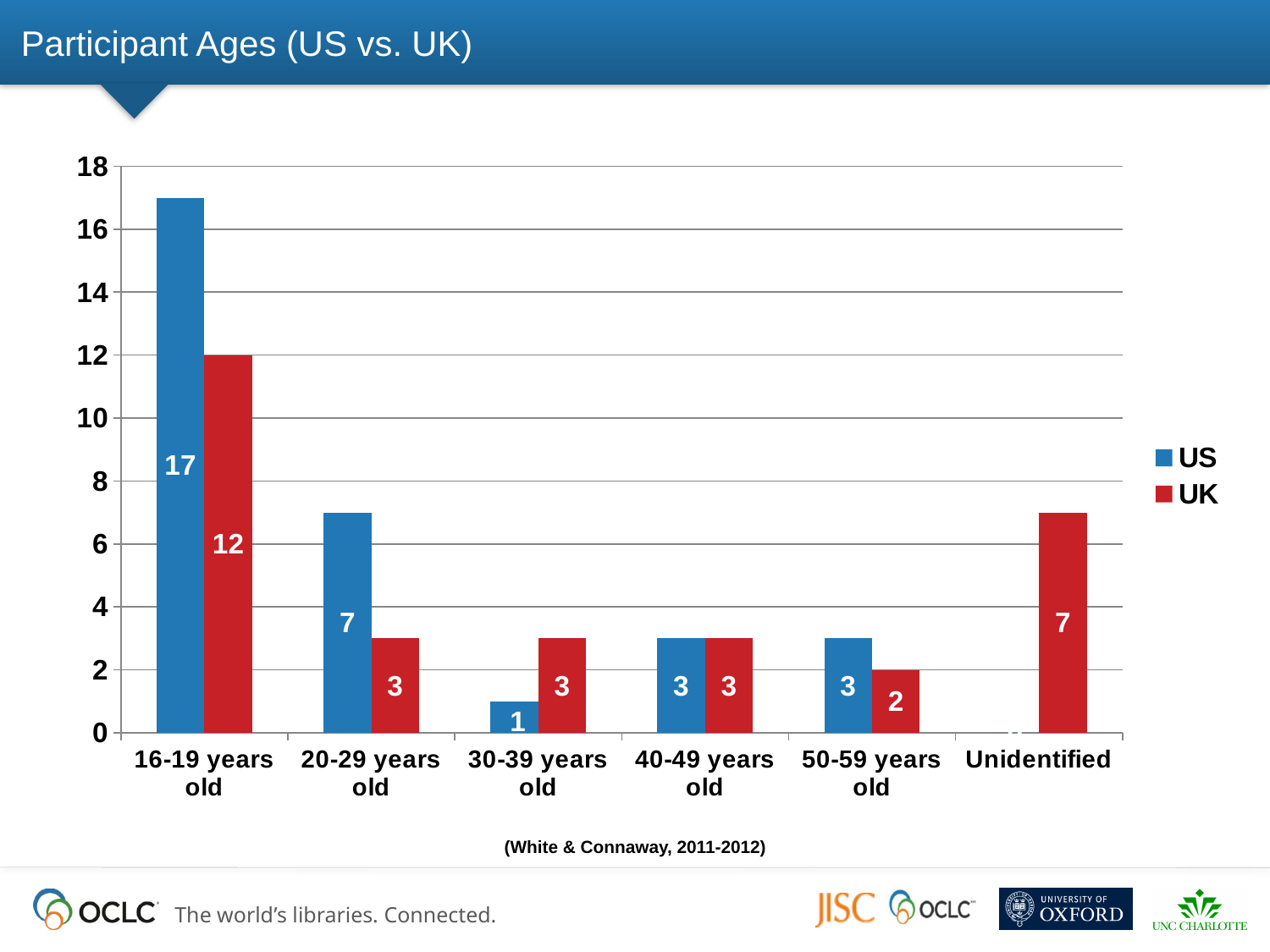
What is the UK value for 20-29 years old? 3 Which age category has the highest US value? 16-19 years old What is the title of the slide? Participant Ages (US vs. UK) What kind of chart is shown on the slide? bar chart What is the UK value for Unidentified? 7 Which age category has the lowest US value among those with a labelled bar? 30-39 years old Which is larger for 20-29 years old, the US value or the UK value? US How many age categories are shown on the x axis? 6 What is the difference between the US and UK values for 16-19 years old? 5 What is the US value for 16-19 years old? 17 Is the US value for 16-19 years old greater or less than 16? greater How many series does the legend list? 2